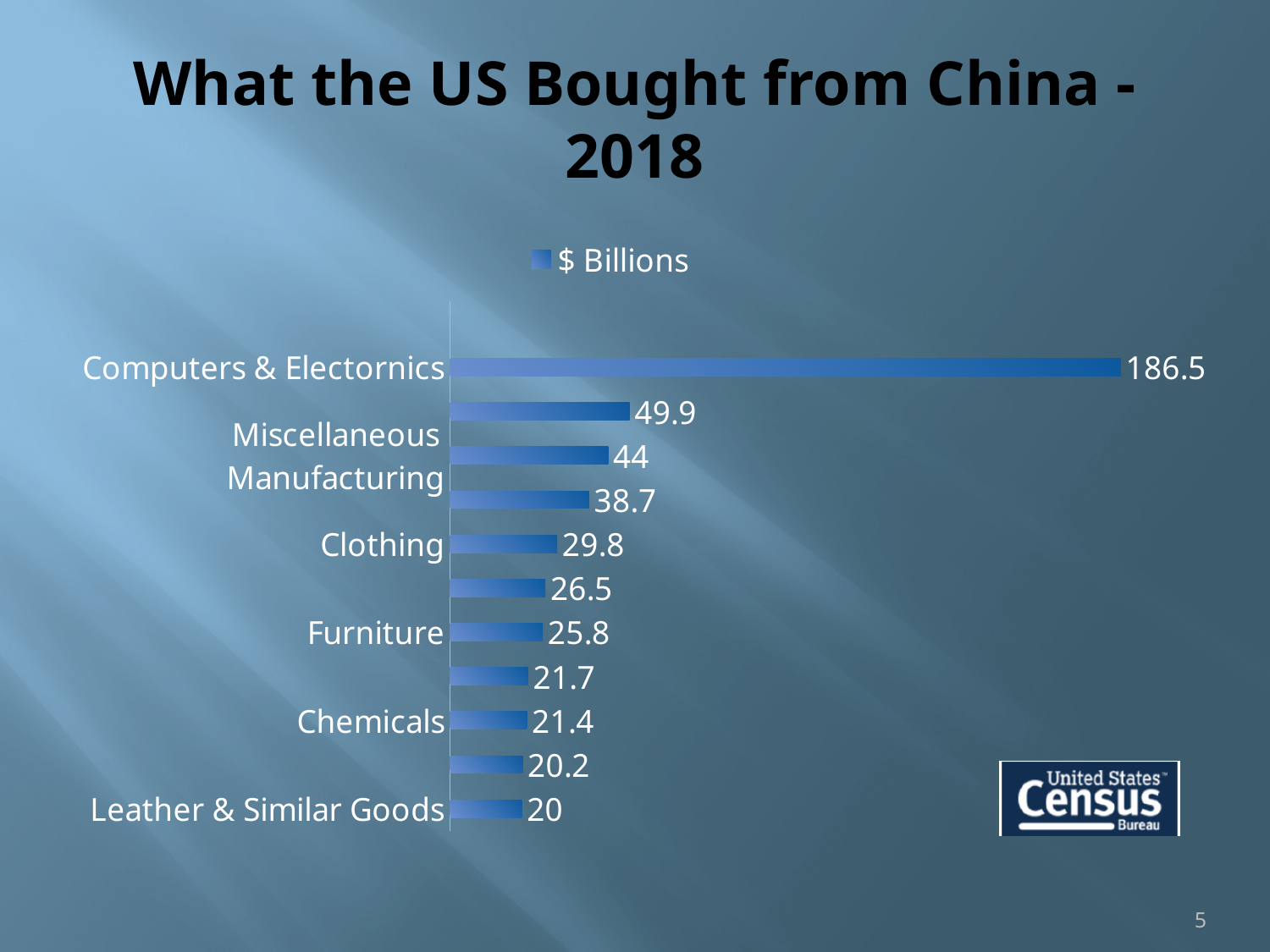
What is the value for Computers & Electornics? 186.5 How many bars are plotted in the chart? 11 What is the value for Clothing? 29.8 What kind of chart is shown on the slide? Bar chart What is the value for Leather & Similar Goods? 20 What is the difference between the values for Computers & Electornics and Miscellaneous Manufacturing? 142.5 What is the value for Furniture? 25.8 What is the value for Miscellaneous Manufacturing? 44 Which category has the highest value? Computers & Electornics Which category has the lowest value? Leather & Similar Goods What is the value for Chemicals? 21.4 Which is larger, the value for Clothing or the value for Furniture? Clothing